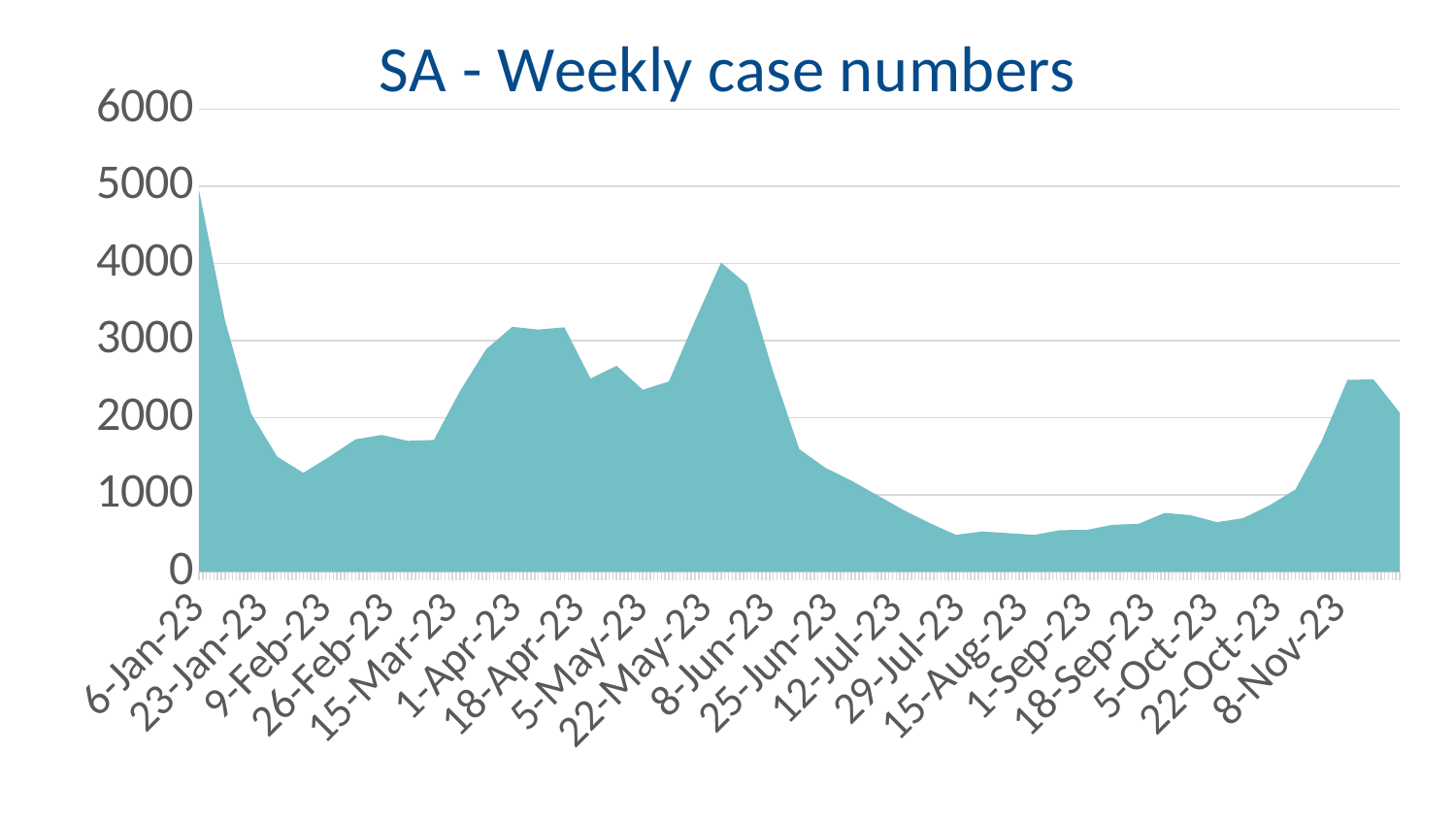
What kind of chart is shown on the slide? Area chart Is the value for 1-Apr-23 greater or less than 2000? greater Is the value for 9-Feb-23 greater or less than 2000? less Do the weekly case numbers rise or fall between 6-Jan-23 and 9-Feb-23? fall Is the value for 12-Jul-23 greater or less than 2000? less What is the title of the chart? SA - Weekly case numbers Which is larger, the value for 6-Jan-23 or the value for 8-Jun-23? 6-Jan-23 Do the weekly case numbers rise or fall between 22-Oct-23 and 8-Nov-23? rise Which is larger, the value for 1-Apr-23 or the value for 15-Aug-23? 1-Apr-23 Which date on the x axis has the highest weekly case number? 6-Jan-23